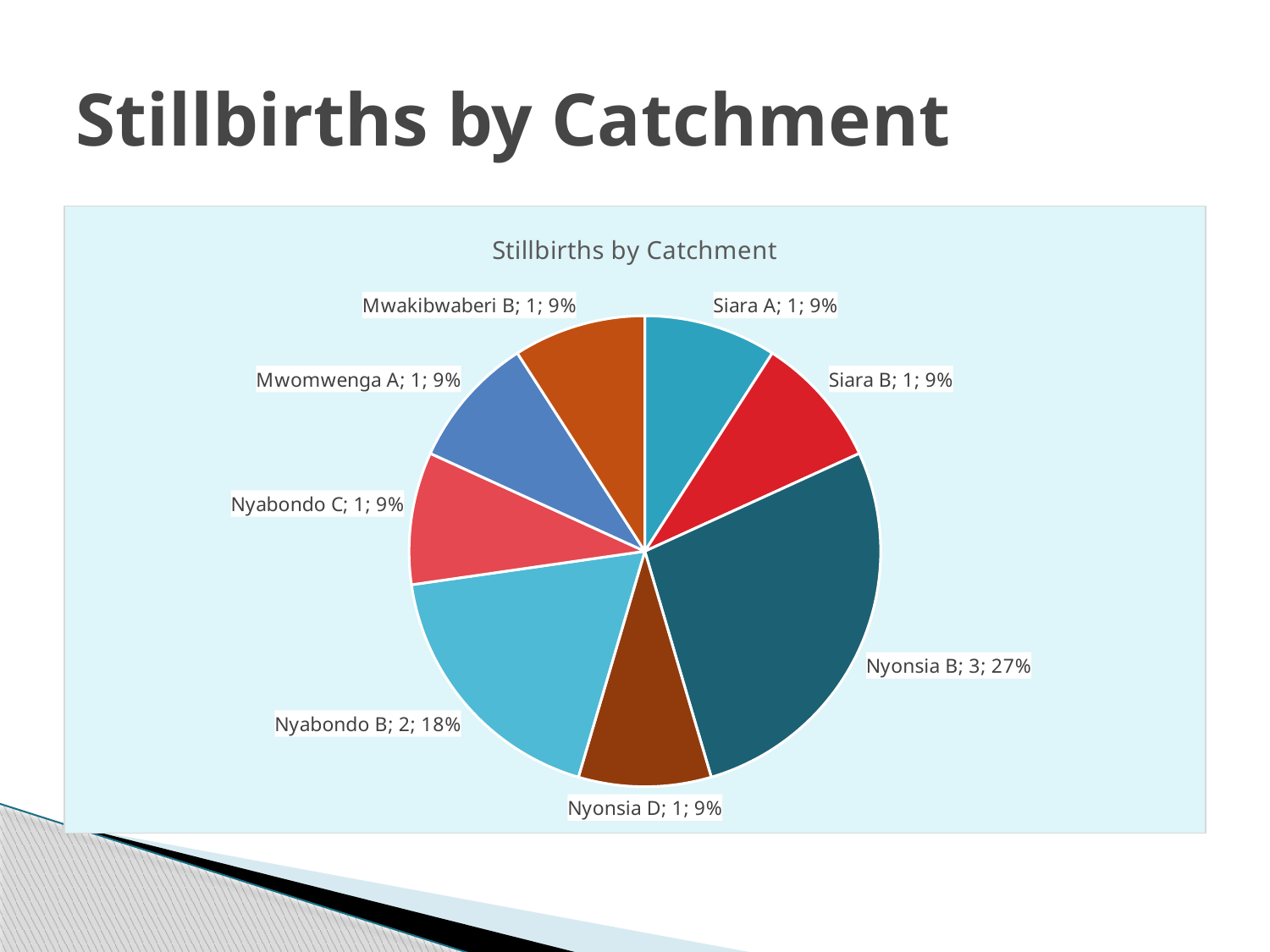
Which is larger, the value for Nyabondo B or the value for Siara A? Nyabondo B What share of the pie does Nyonsia B represent? 27% What share of the pie does Nyabondo B represent? 18% How many stillbirths are shown for Nyonsia B? 3 How many stillbirths are shown for Nyabondo B? 2 What share of the pie does Mwakibwaberi B represent? 9% What is the total number of stillbirths across all catchments in the pie chart? 11 What kind of chart is shown on the slide? pie chart Which catchment has the largest slice of the pie? Nyonsia B What is the difference in stillbirths between Nyonsia B and Nyabondo B? 1 What is the title of the chart? Stillbirths by Catchment How many catchments (slices) are shown in the pie chart? 8